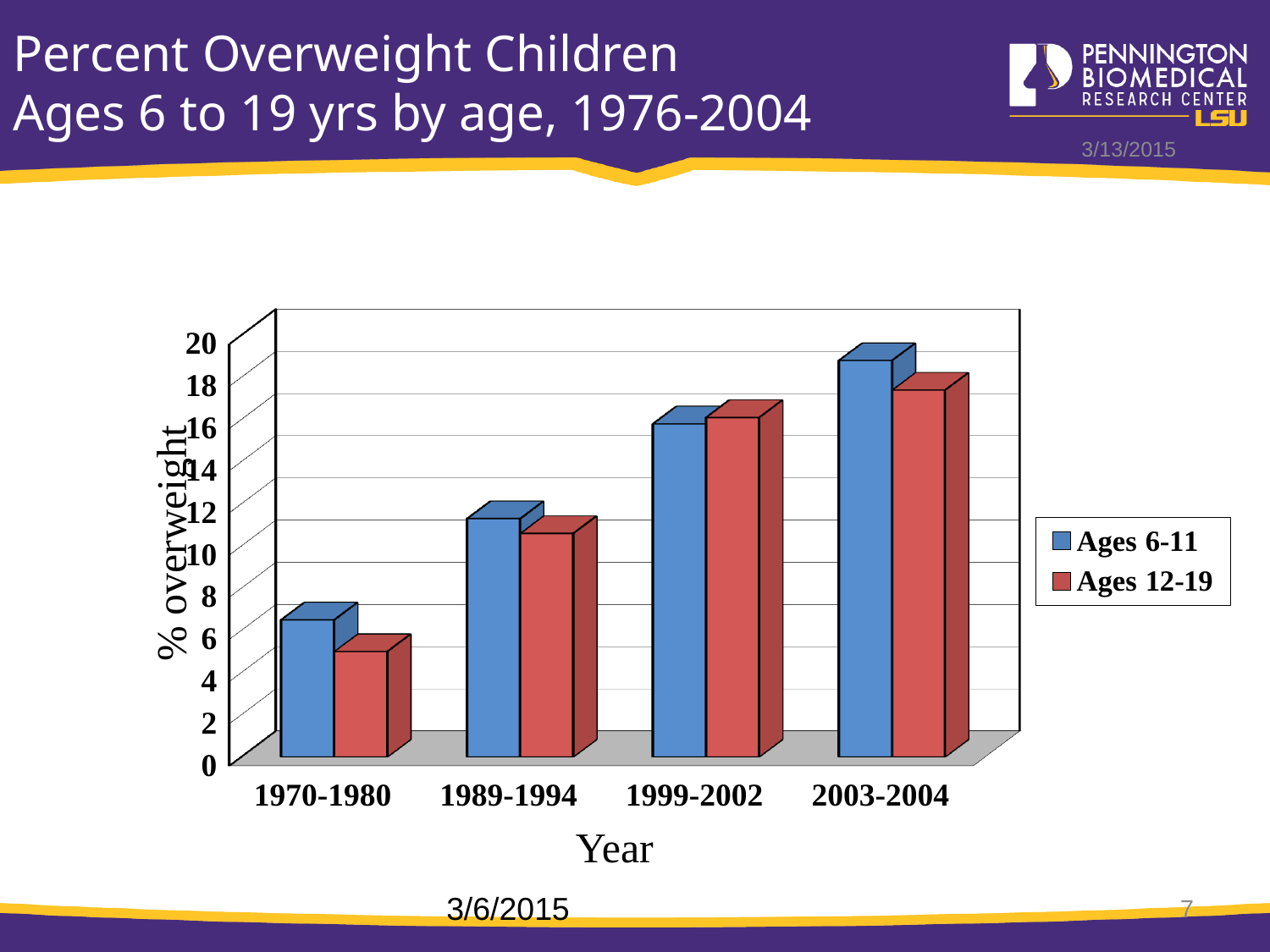
Do the Ages 12-19 values rise or fall across the year categories from 1970-1980 to 2003-2004? rise How many year categories are shown on the x axis? 4 Is the Ages 6-11 value for 1970-1980 greater or less than 10? less For 1970-1980, which series has the larger value, Ages 6-11 or Ages 12-19? Ages 6-11 Is the Ages 6-11 value for 2003-2004 greater or less than 16? greater In which year category is the Ages 12-19 value lowest? 1970-1980 What is the title of the vertical axis? % overweight What kind of chart is shown on the slide? Bar chart Is the Ages 12-19 value for 1999-2002 greater or less than 12? greater In which year category is the Ages 6-11 value highest? 2003-2004 For 2003-2004, which series has the larger value, Ages 6-11 or Ages 12-19? Ages 6-11 How many series does the legend list? 2